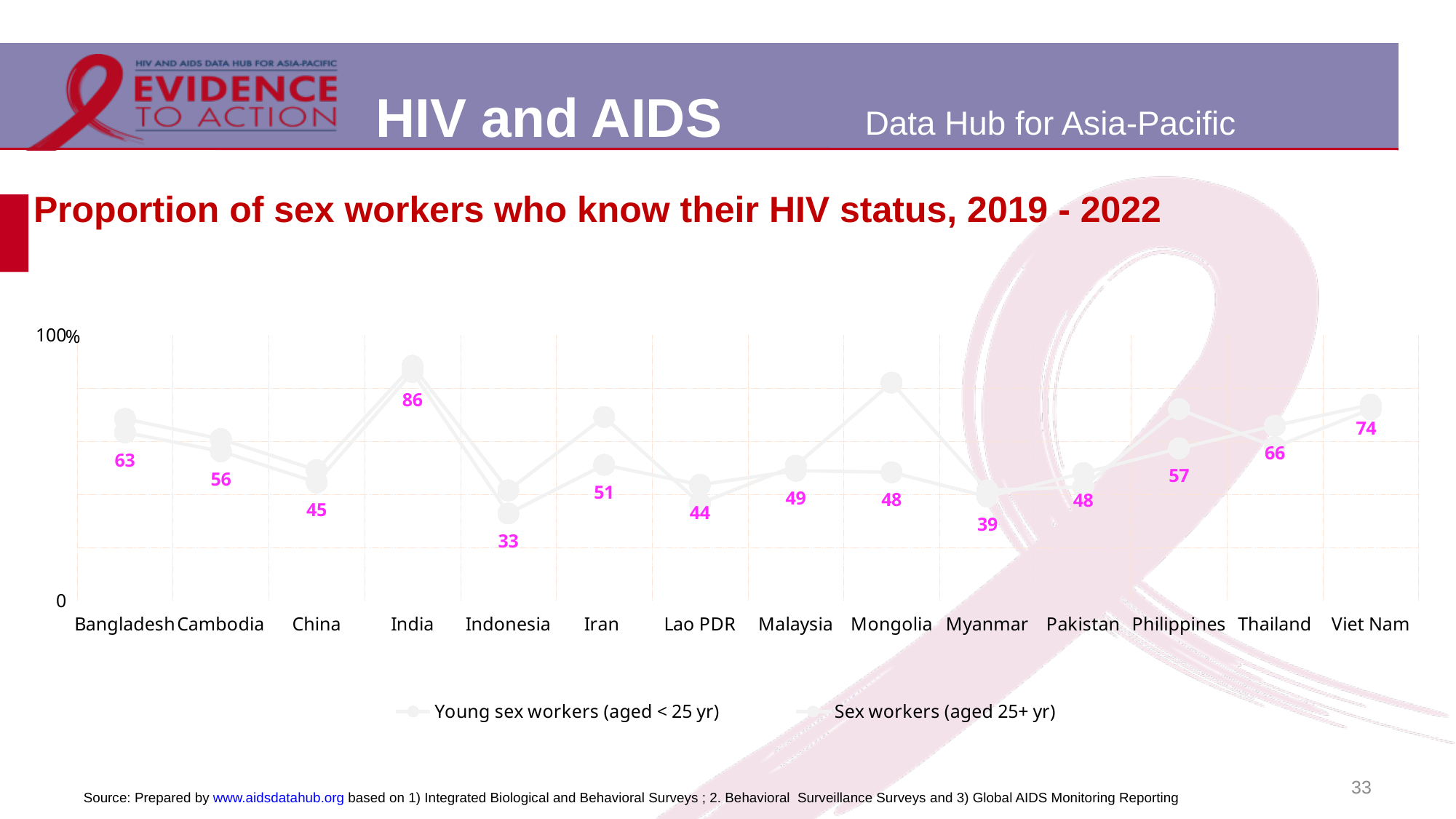
What is the difference between the labelled values for India and Indonesia? 53 What type of chart is shown on the slide? line chart How many series does the legend list? 2 What is the data label shown for Indonesia? 33 Which country has the lowest labelled value? Indonesia Which has the larger labelled value, Thailand or Viet Nam? Viet Nam What is the title of the chart? Proportion of sex workers who know their HIV status, 2019 - 2022 What is the data label shown for Myanmar? 39 What is the data label shown for India? 86 What is the data label shown for Viet Nam? 74 How many countries are shown on the x axis? 14 Which country has the highest labelled value? India